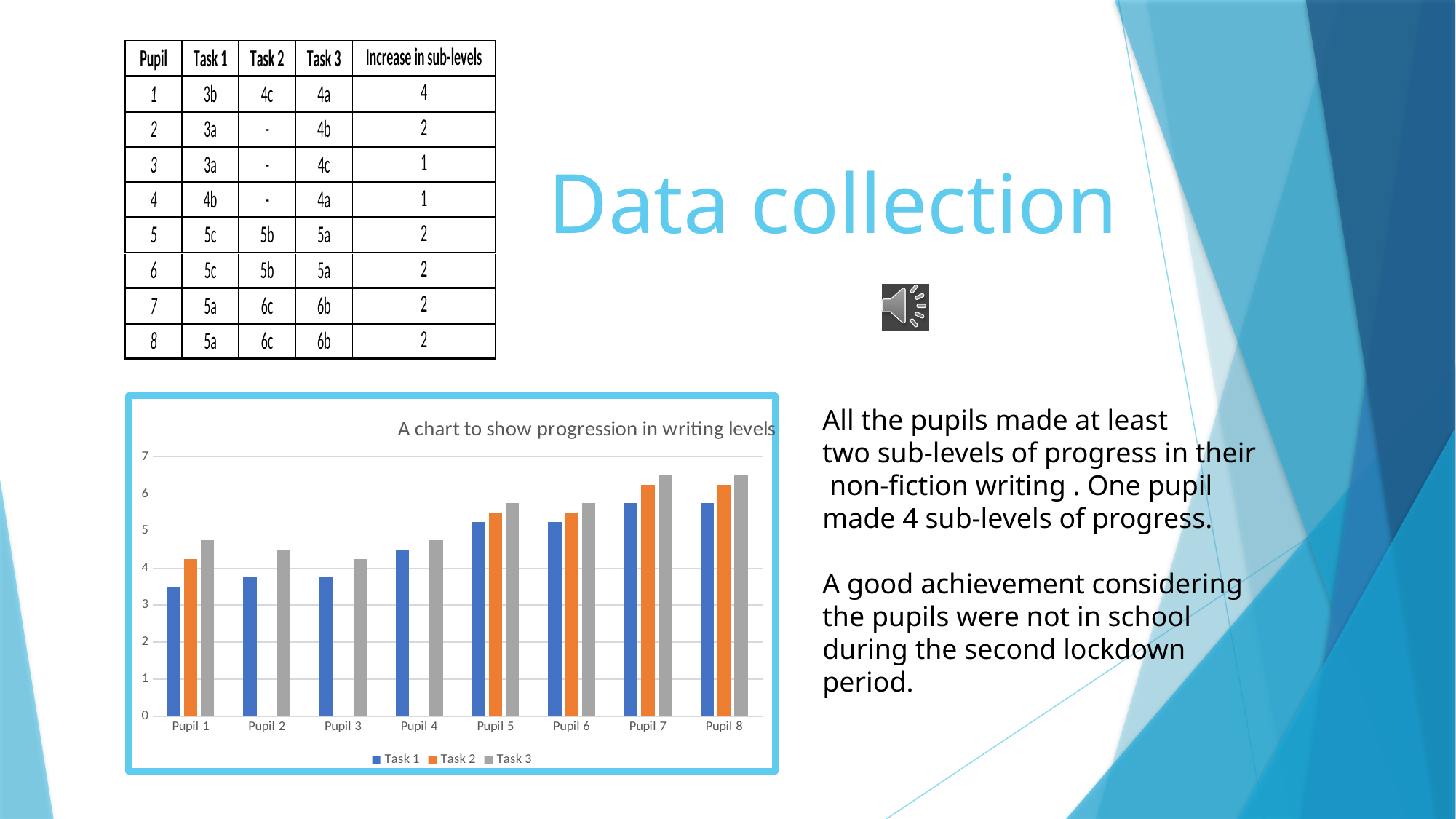
Is the Task 1 value for Pupil 5 greater or less than 5? greater For Pupil 1, which is larger: the Task 1 value or the Task 3 value? Task 3 Is the Task 1 value for Pupil 4 greater or less than 5? less How many pupils are shown on the x axis of the chart? 8 Do the Task 1 values generally rise or fall from Pupil 1 to Pupil 8? rise What is the title of the chart? A chart to show progression in writing levels Which pupils have no Task 2 bar in the chart? Pupil 2, Pupil 3 and Pupil 4 How many series does the chart legend list? 3 Which is larger: the Task 1 value for Pupil 1 or the Task 1 value for Pupil 5? Pupil 5 Is the Task 1 value for Pupil 1 greater or less than 4? less What kind of chart is shown on the slide? bar chart